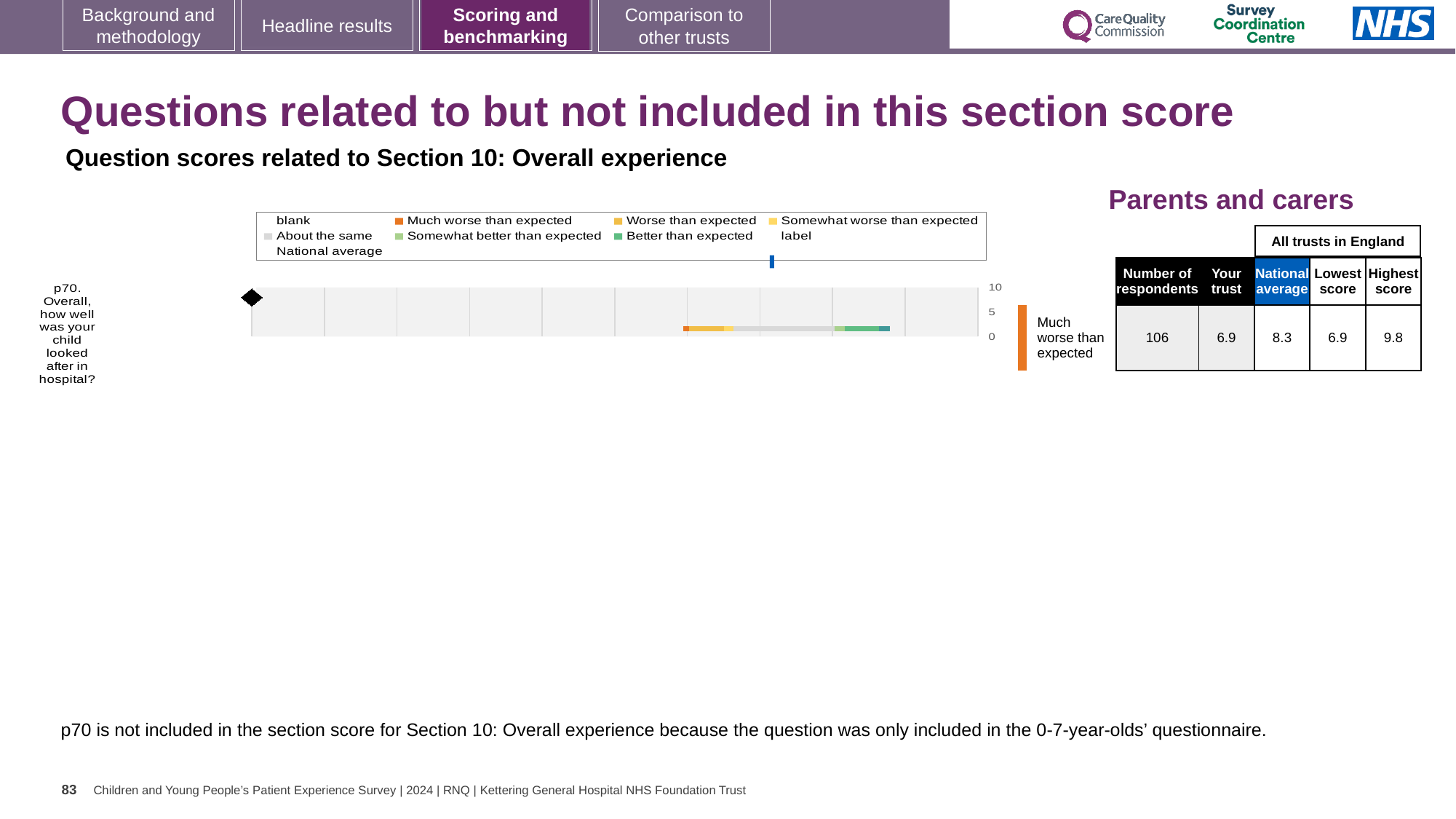
What is the lowest score among all trusts in England for question p70? 6.9 Which is larger for question p70: the trust's score or the national average? National average What is the national average score for question p70? 8.3 What is the difference between the national average and the trust's score for question p70? 1.4 What kind of chart is shown on this slide? Bar chart What is the highest score among all trusts in England for question p70? 9.8 What is the 'Your trust' score for question p70 shown on the slide? 6.9 How many respondents answered question p70? 106 What is the difference between the highest and lowest scores across all trusts for question p70? 2.9 How many questions are plotted in the chart on this slide? 1 What benchmark rating is shown next to the chart for question p70? Much worse than expected Which section do the question scores on this slide relate to? Section 10: Overall experience